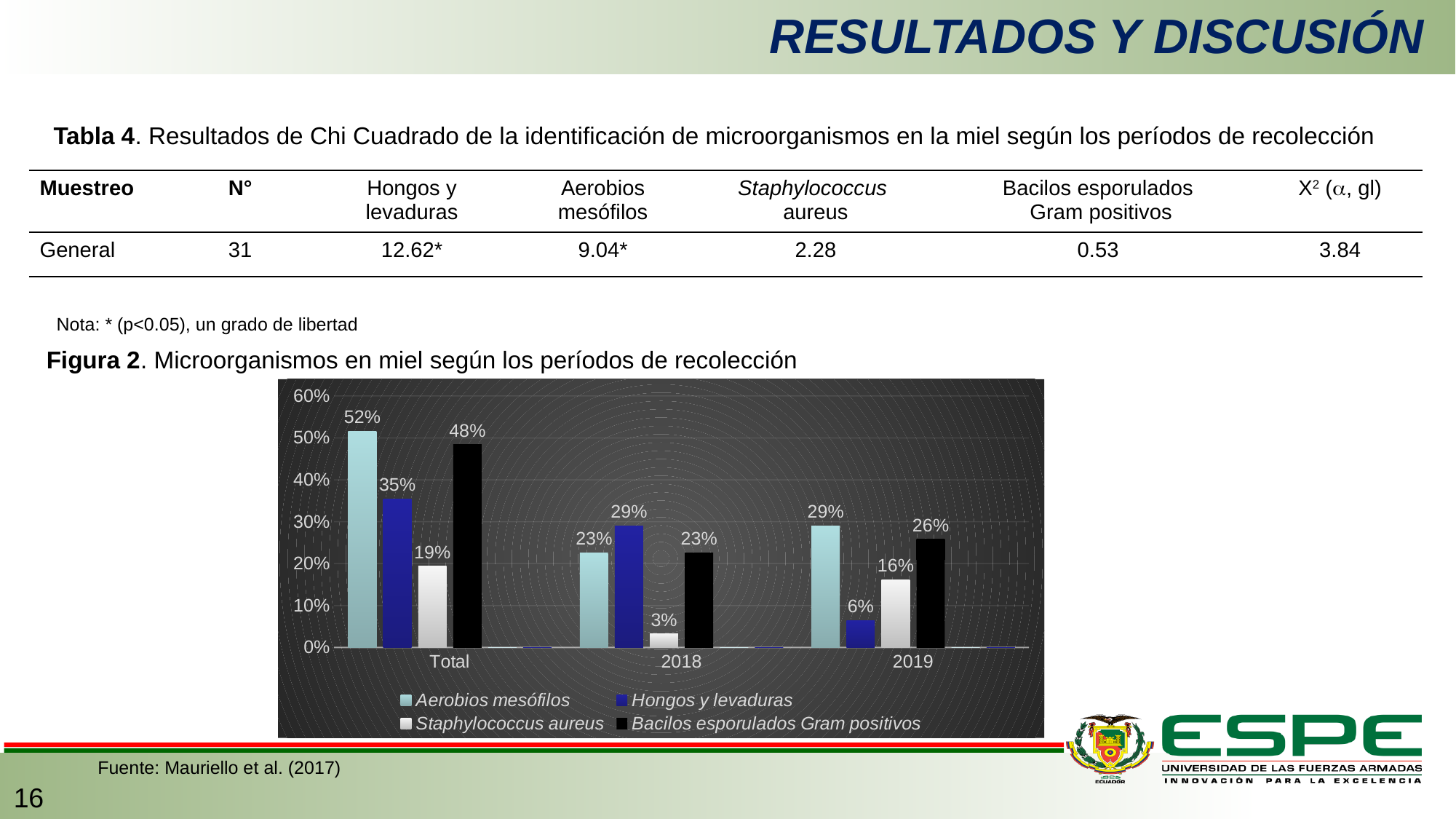
What type of chart is shown in Figura 2? bar chart Which series is shown in black in the chart? Bacilos esporulados Gram positivos What is the value for Hongos y levaduras in 2019? 6% Which is larger in 2019: Aerobios mesófilos or Bacilos esporulados Gram positivos? Aerobios mesófilos What is the value for Staphylococcus aureus in 2018? 3% What is the difference between Aerobios mesófilos and Bacilos esporulados Gram positivos in the Total category? 4% What is the value for Bacilos esporulados Gram positivos in 2019? 26% What is the value for Aerobios mesófilos in the Total category? 52% How many categories are shown on the x axis of the chart? 3 How many series does the legend of the chart list? 4 Which series has the lowest value in 2018? Staphylococcus aureus Which series has the highest value in the Total category? Aerobios mesófilos